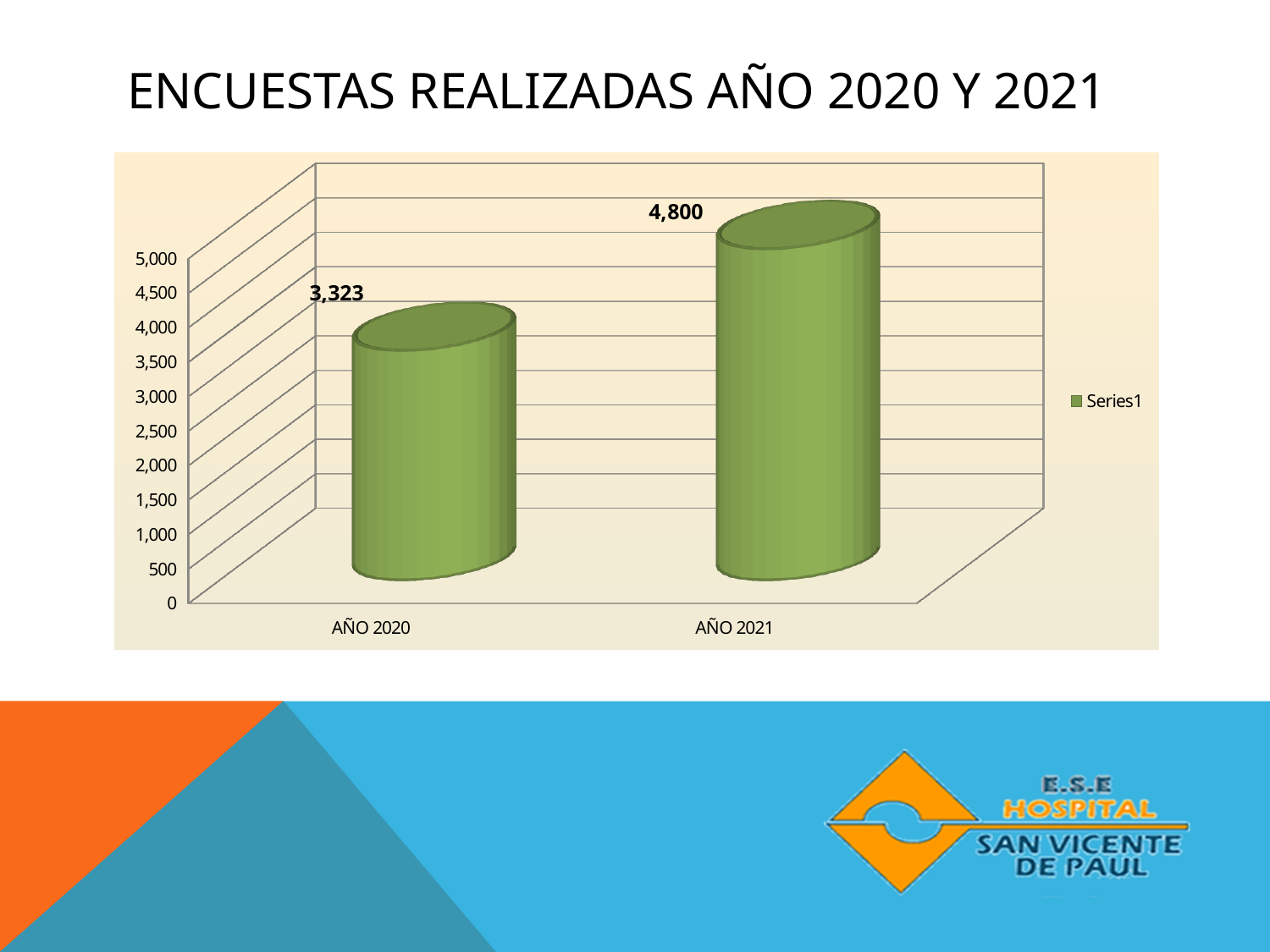
Do the values rise or fall from AÑO 2020 to AÑO 2021? rise What kind of chart is shown on the slide? bar chart Is the value for AÑO 2020 greater or less than 3,000? greater What is the difference between the values for AÑO 2021 and AÑO 2020? 1,477 How many series does the legend list? 1 Is the value for AÑO 2021 greater or less than 5,000? less Which category has the highest value? AÑO 2021 What is the value for AÑO 2021? 4,800 What is the value for AÑO 2020? 3,323 Which category has the lowest value? AÑO 2020 Which is larger, the value for AÑO 2020 or AÑO 2021? AÑO 2021 How many categories are shown on the x axis? 2